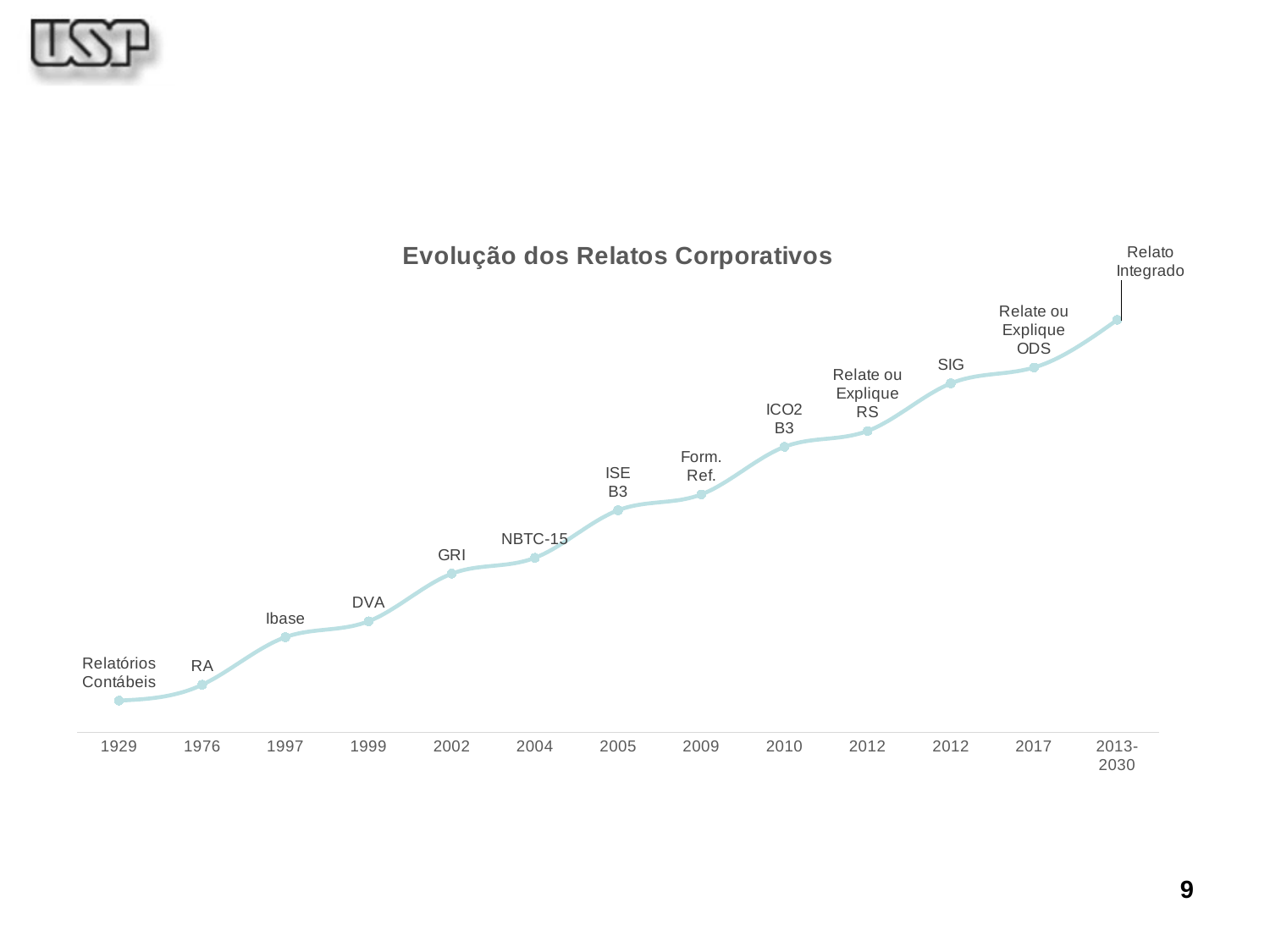
Do the values rise or fall along the x axis from 1929 to 2013-2030? Rise Which point is higher on the line, 2005 (ISE B3) or 2017 (Relate ou Explique ODS)? 2017 (Relate ou Explique ODS) What label is shown at the 1929 point? Relatórios Contábeis What label is shown at the 2010 point? ICO2 B3 What kind of chart is shown on the slide? Line chart How many data points are plotted on the line? 13 What label is shown at the 2004 point? NBTC-15 Which x-axis category has the lowest point on the line? 1929 What label is shown at the 2013-2030 point? Relato Integrado Which x-axis category has the highest point on the line? 2013-2030 What label is shown at the 1999 point? DVA What is the title of the chart? Evolução dos Relatos Corporativos